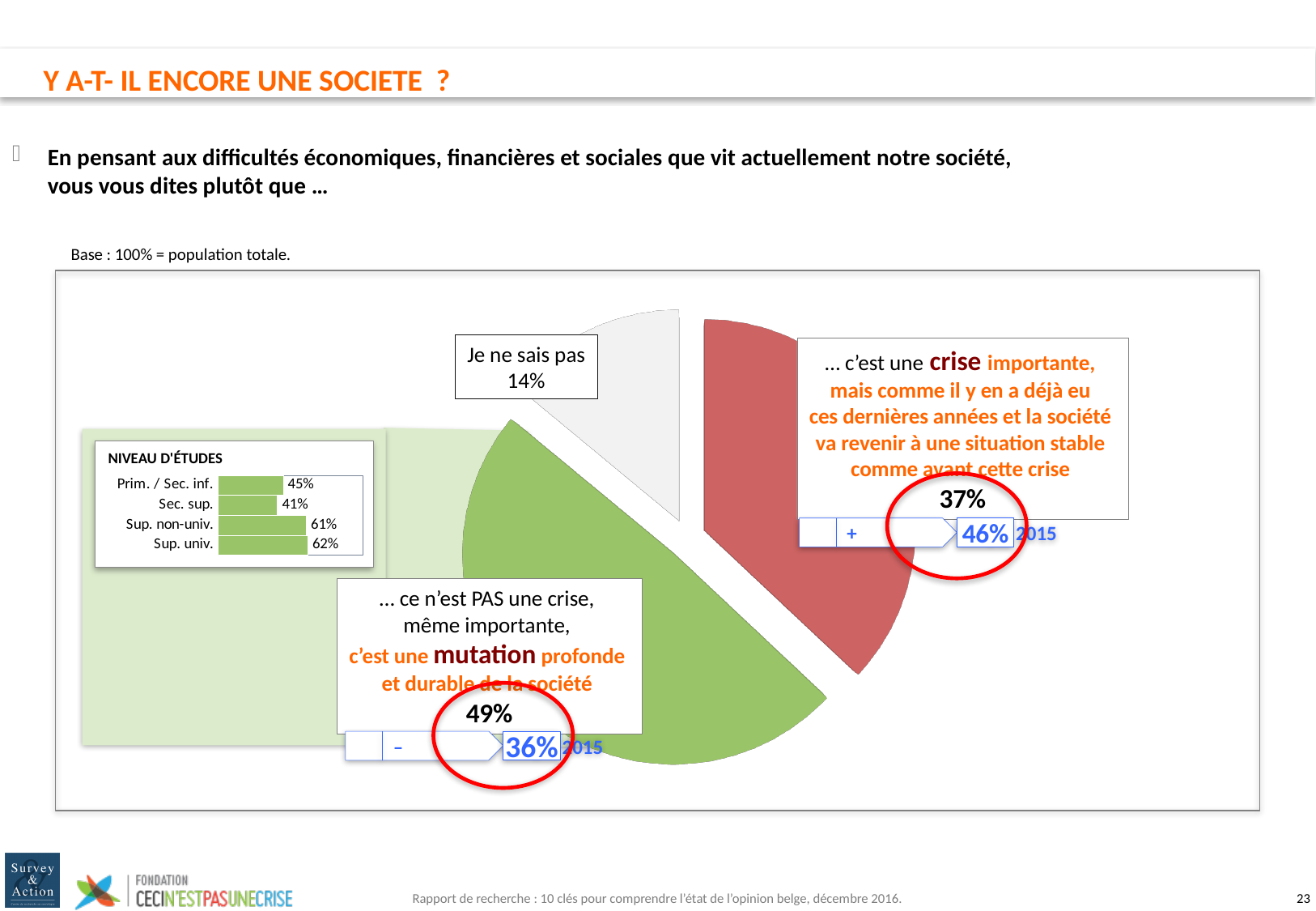
In the "NIVEAU D'ÉTUDES" bar chart, which education level has the lowest value? Sec. sup. In the pie chart, what is the difference in percentage points between the "mutation" response (49%) and the "crise importante" response (37%)? 12 In the "NIVEAU D'ÉTUDES" bar chart, what is the value for "Sec. sup."? 41% In the pie chart, what percentage say it is a "mutation profonde et durable de la société"? 49% In the pie chart, what percentage say it is a "crise importante" after which society will return to a stable situation? 37% In the pie chart, which response has the smallest share? Je ne sais pas In the "NIVEAU D'ÉTUDES" bar chart, what is the value for "Sup. univ."? 62% In the pie chart, what share of respondents answered "Je ne sais pas"? 14% How many categories are shown in the "NIVEAU D'ÉTUDES" bar chart? 4 What was the 2015 value shown for the "mutation profonde" response? 36% What was the 2015 value shown for the "crise importante" response? 46% In the pie chart, which response has the largest share? … ce n'est PAS une crise, c'est une mutation profonde et durable de la société